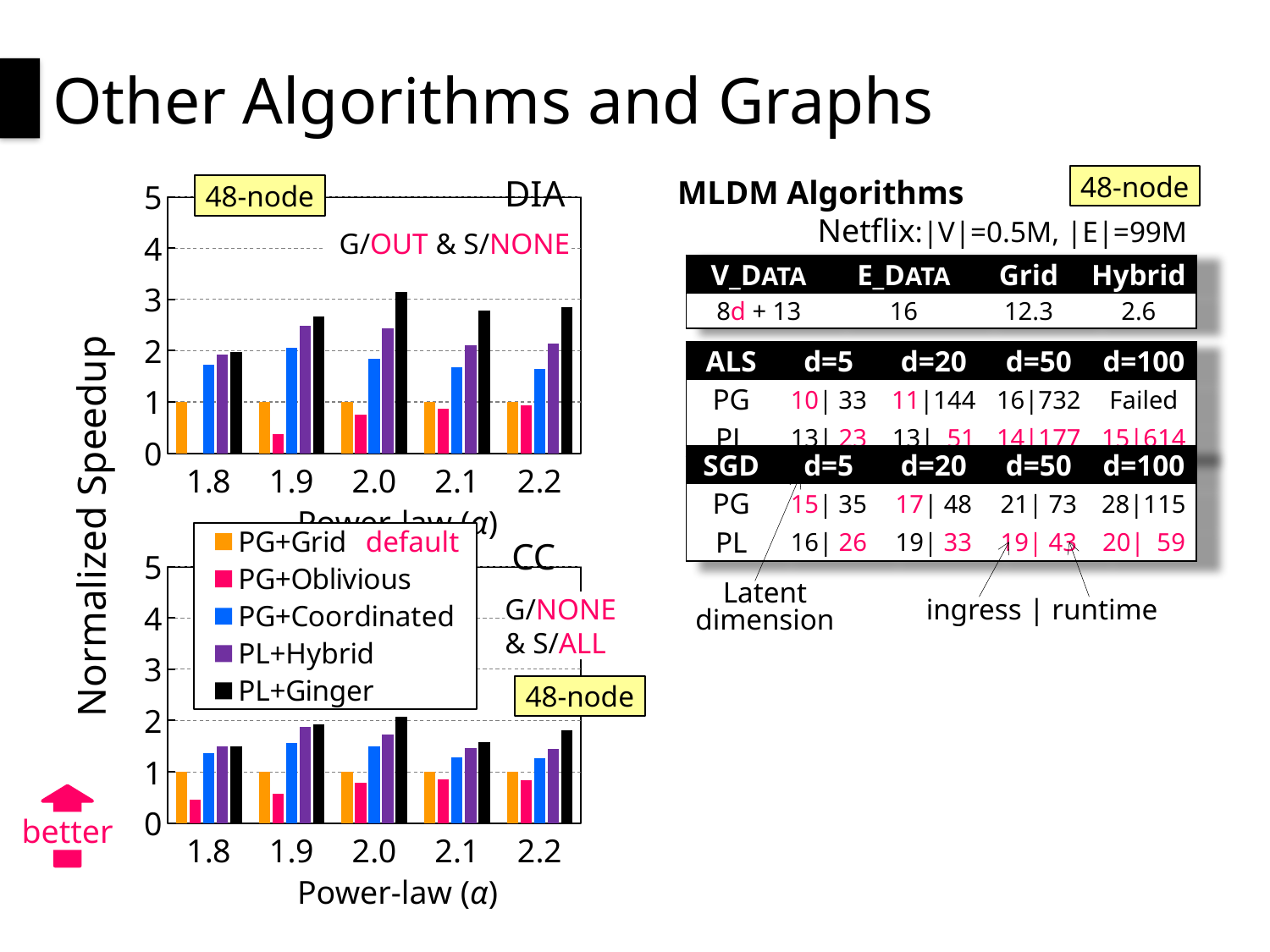
In the DIA chart, is the PL+Ginger value at Power-law 2.2 greater or less than 2? greater How many Power-law (α) categories are shown on the x axis of the CC chart? 5 What kind of chart is the top chart labelled DIA? bar chart In the CC chart, is the PL+Ginger value at Power-law 2.2 greater or less than 2? less In the CC chart, which is larger at Power-law 1.9: PL+Hybrid or PG+Coordinated? PL+Hybrid In the DIA chart, which series has the tallest bar at Power-law 2.0? PL+Ginger In the DIA chart, at which Power-law value is the PL+Ginger bar the tallest? 2.0 In the DIA chart, which series has the shortest bar at Power-law 1.9? PG+Oblivious In the DIA chart, is the PG+Oblivious value at Power-law 1.9 greater or less than 1? less In the CC chart, which series has the shortest bar at Power-law 1.8? PG+Oblivious How many series does the legend shared by the DIA and CC charts list? 5 What is the y-axis label shared by the DIA and CC charts? Normalized Speedup